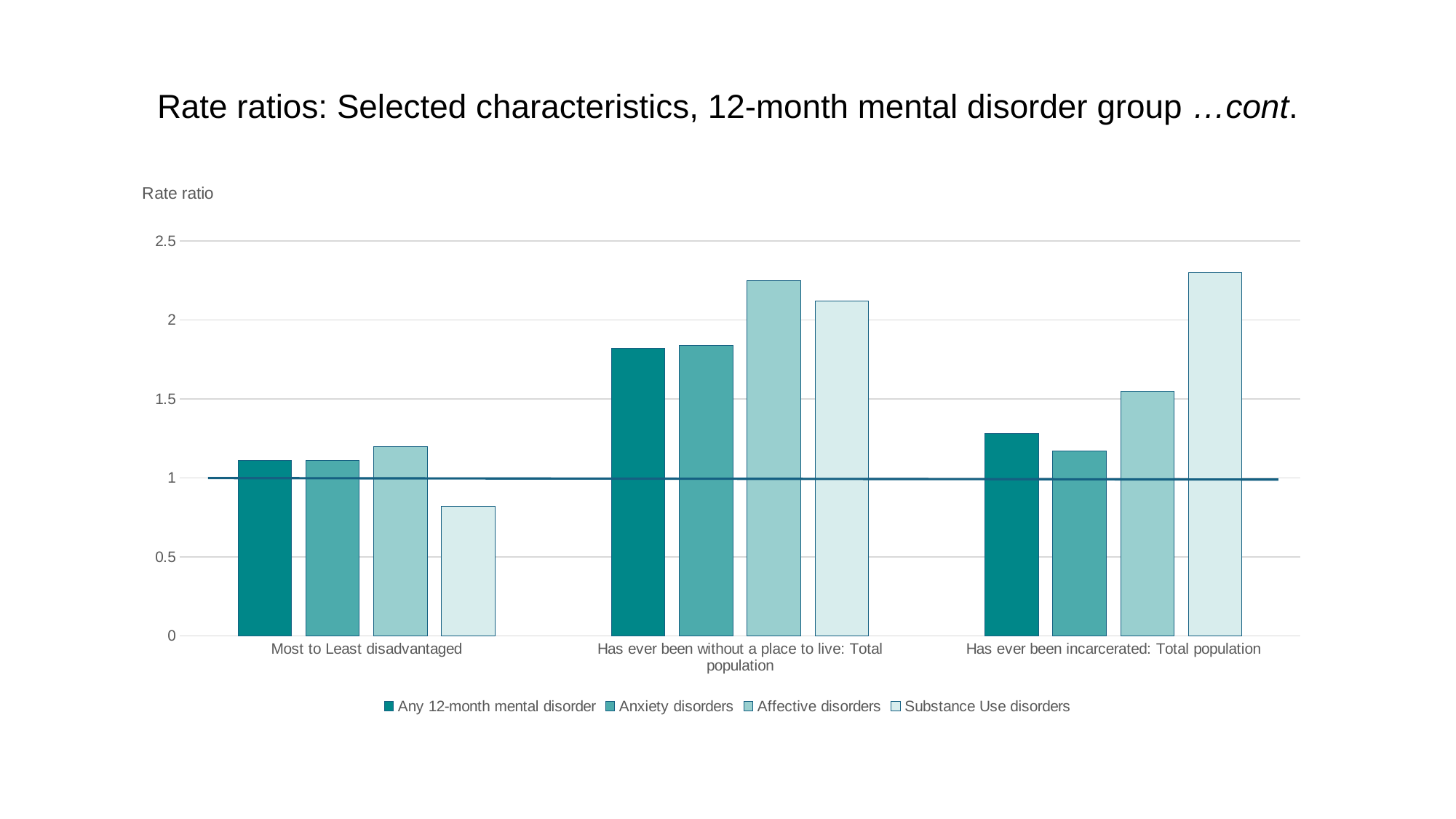
Which series has the lowest value in the 'Most to Least disadvantaged' category? Substance Use disorders What kind of chart is shown on the slide? Bar chart At what value on the vertical axis is the horizontal reference line drawn? 1 Is the value for Substance Use disorders in the 'Most to Least disadvantaged' category greater or less than 1? less Which series has the highest value in the 'Has ever been without a place to live: Total population' category? Affective disorders Is the value for Affective disorders in the 'Has ever been without a place to live: Total population' category greater or less than 2? greater What is the label on the vertical axis? Rate ratio Which series has the highest value in the 'Has ever been incarcerated: Total population' category? Substance Use disorders In the 'Has ever been without a place to live: Total population' category, which is larger: Affective disorders or Substance Use disorders? Affective disorders How many series does the legend list? 4 Is the value for Any 12-month mental disorder in the 'Has ever been incarcerated: Total population' category greater or less than 1.5? less How many categories are shown on the x axis? 3